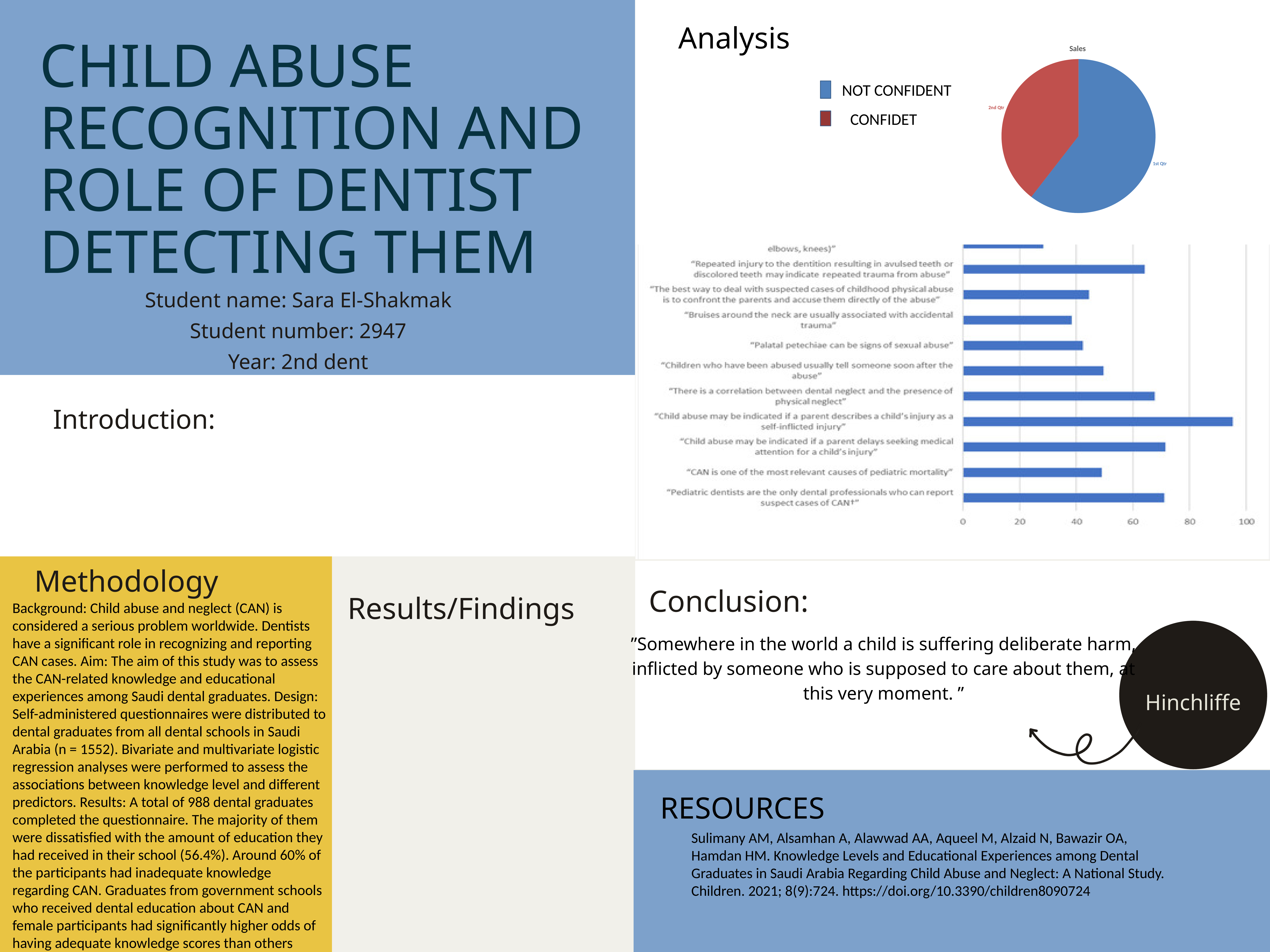
In the bar chart listing statements about child abuse, which statement has the highest value? "Child abuse may be indicated if a parent describes a child's injury as a self-inflicted injury" In the bar chart listing statements about child abuse, how many bars are plotted? 11 In the bar chart listing statements about child abuse, is the value for "Child abuse may be indicated if a parent describes a child's injury as a self-inflicted injury" greater or less than 80? greater In the pie chart titled "Sales", what colour is the 1st Qtr slice? blue What kind of chart is the chart below the pie chart, listing statements about child abuse? bar chart In the pie chart titled "Sales", how many slices are there? 2 In the bar chart listing statements about child abuse, is the value for "Palatal petechiae can be signs of sexual abuse" greater or less than 60? less In the bar chart listing statements about child abuse, is the value for "Pediatric dentists are the only dental professionals who can report suspect cases of CAN" greater or less than 60? greater In the bar chart listing statements about child abuse, what is the maximum value shown on the horizontal axis? 100 In the bar chart listing statements about child abuse, which has the larger value: "Child abuse may be indicated if a parent describes a child's injury as a self-inflicted injury" or "Bruises around the neck are usually associated with accidental trauma"? "Child abuse may be indicated if a parent describes a child's injury as a self-inflicted injury" What kind of chart is the chart titled "Sales" at the top right of the slide? pie chart In the pie chart titled "Sales", which slice is larger, 1st Qtr or 2nd Qtr? 1st Qtr